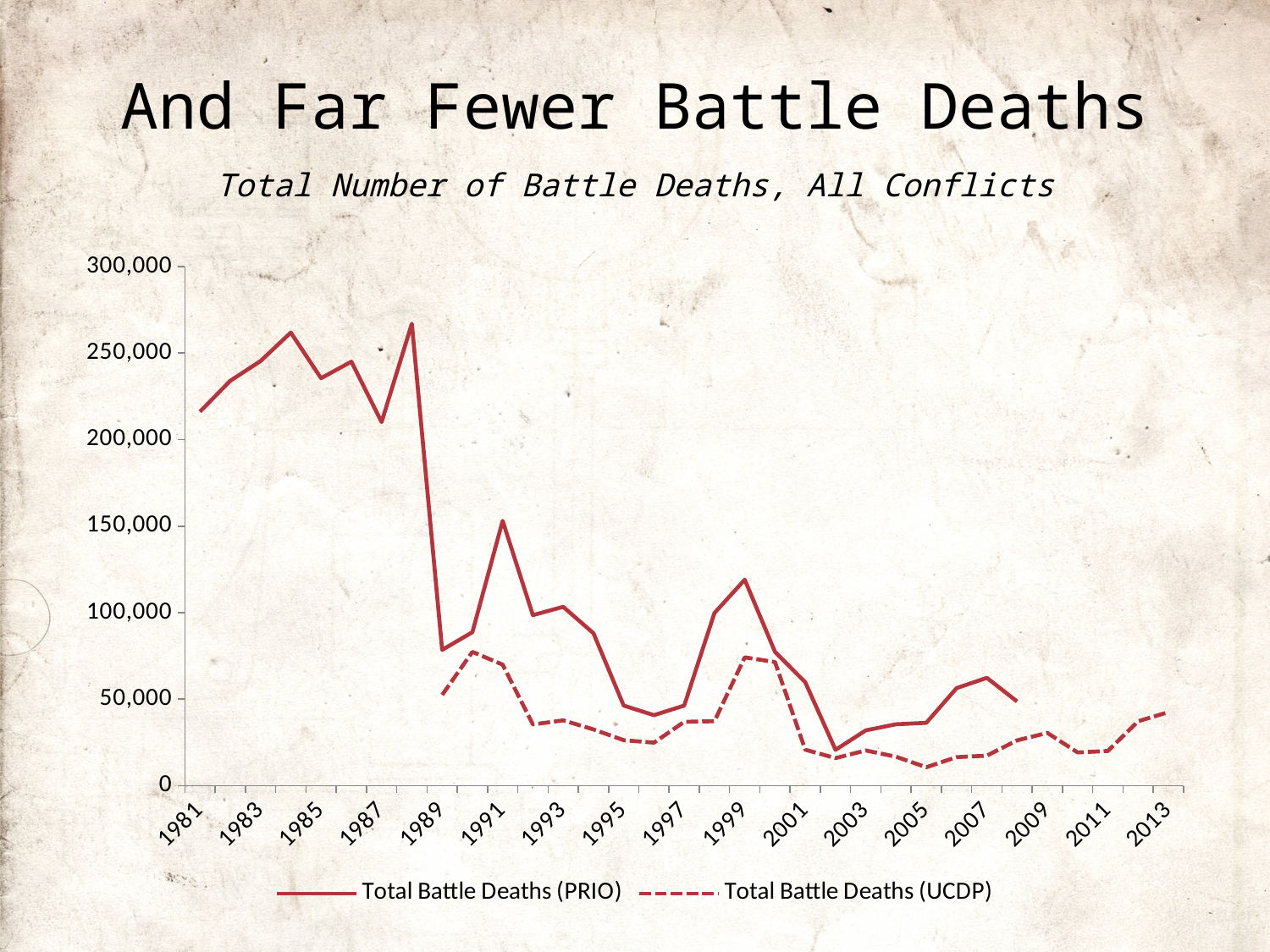
Is the Total Battle Deaths (UCDP) value for 2013 greater or less than 50,000? less What kind of chart is shown on the slide? line chart Which series is drawn with a dashed line? Total Battle Deaths (UCDP) Which is larger for Total Battle Deaths (PRIO): the value in 1985 or the value in 1995? 1985 Is the Total Battle Deaths (UCDP) value for 2001 greater or less than 50,000? less How many series does the legend list? 2 In 1991, which series has the larger value, Total Battle Deaths (PRIO) or Total Battle Deaths (UCDP)? Total Battle Deaths (PRIO) Is the Total Battle Deaths (PRIO) value for 1981 greater or less than 200,000? greater Overall, does the Total Battle Deaths (PRIO) series rise or fall from 1981 to 2008? fall What is the chart's title? Total Number of Battle Deaths, All Conflicts In which year does the Total Battle Deaths (PRIO) series reach its highest value? 1988